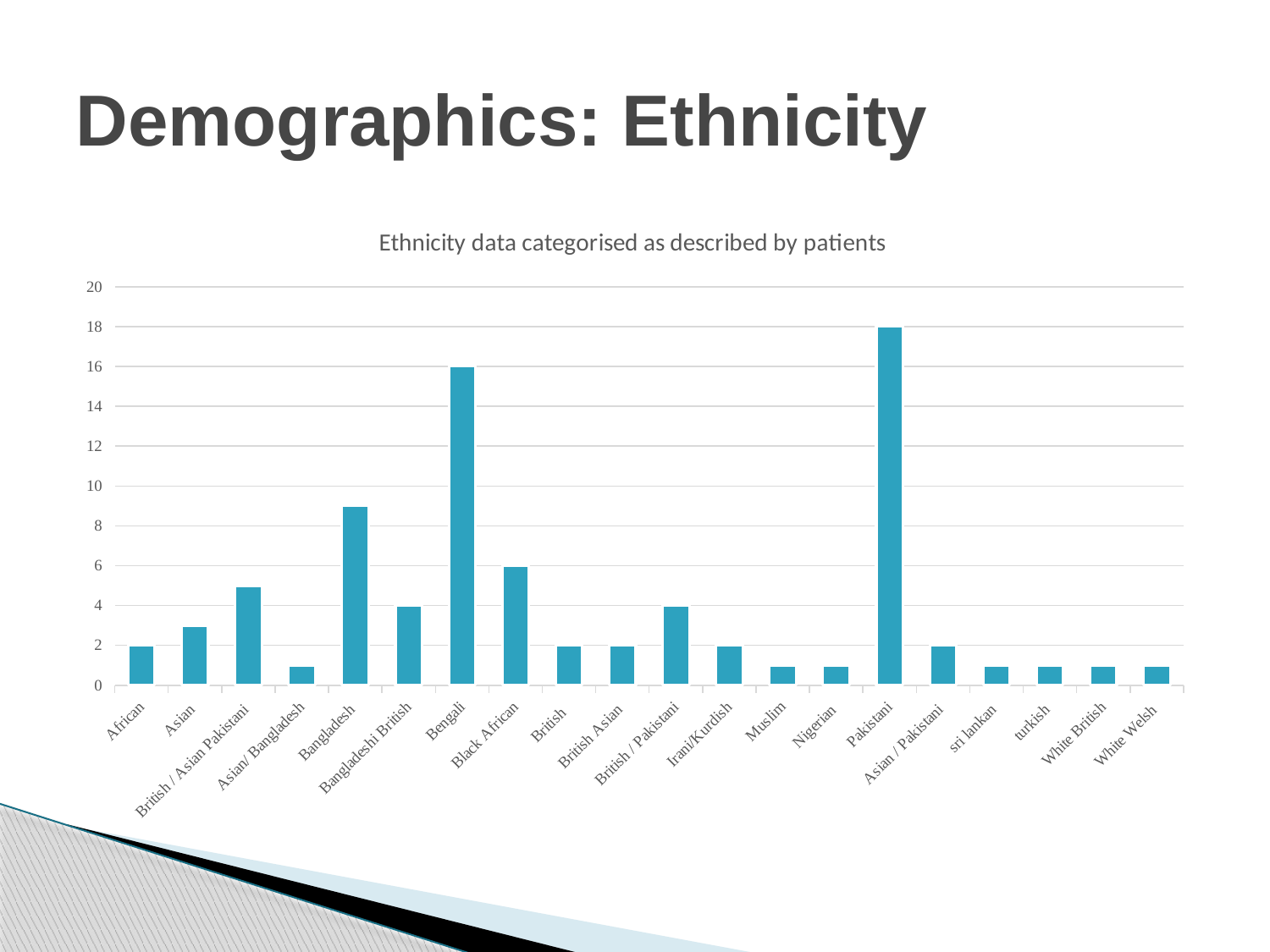
How many ethnicity categories are shown on the x axis? 20 What is the value for Bangladeshi British? 4 What is the difference between the values for Pakistani and Bengali? 2 What type of chart is shown on the slide? Bar chart Which is larger, the value for Bengali or the value for Black African? Bengali Is the value for Bangladesh greater or less than 8? greater What is the value for Black African? 6 Which ethnicity category has the highest value? Pakistani What is the value for Pakistani? 18 Is the value for Asian greater or less than 4? less What is the title of the chart? Ethnicity data categorised as described by patients What is the value for Bengali? 16